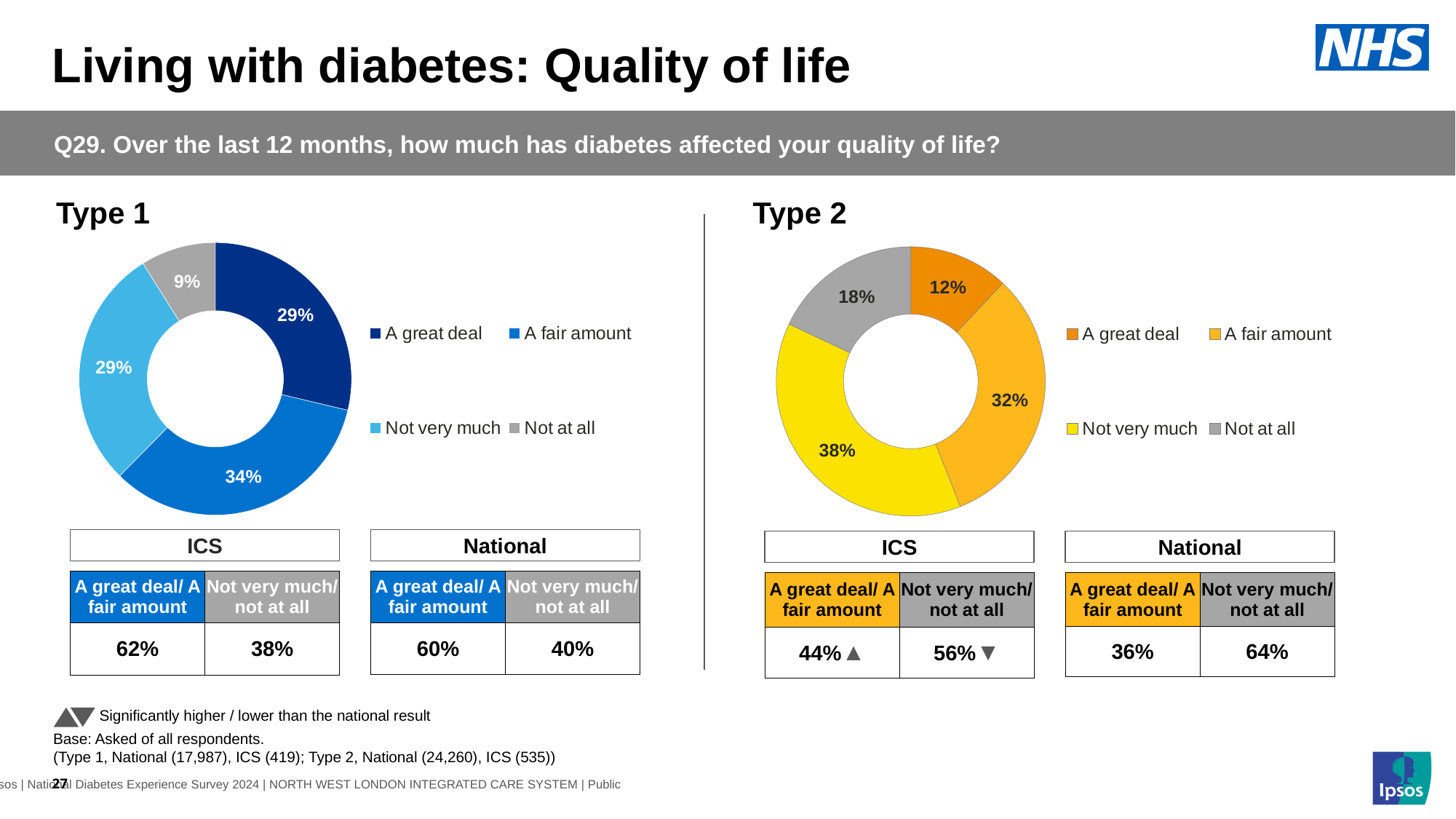
In the Type 1 chart, what colour represents 'Not very much'? Light blue How many response categories does the Type 2 chart show? 4 In the Type 2 chart, what is the difference in percentage points between 'Not very much' and 'Not at all'? 20 In the Type 1 chart, which is larger: 'A fair amount' or 'Not at all'? A fair amount In the Type 1 chart, which response category has the largest share? A fair amount In the Type 2 chart, what percentage said 'A great deal'? 12% In the Type 1 chart, what percentage of respondents said diabetes affected their quality of life 'A fair amount'? 34% In the Type 2 chart, what percentage said 'Not very much'? 38% In the Type 1 chart, what percentage said 'Not at all'? 9% In the Type 2 chart, what is the combined share of 'A great deal' and 'A fair amount'? 44% In the Type 2 chart, which response category has the smallest share? A great deal What kind of chart is used for Type 1? Donut (pie) chart